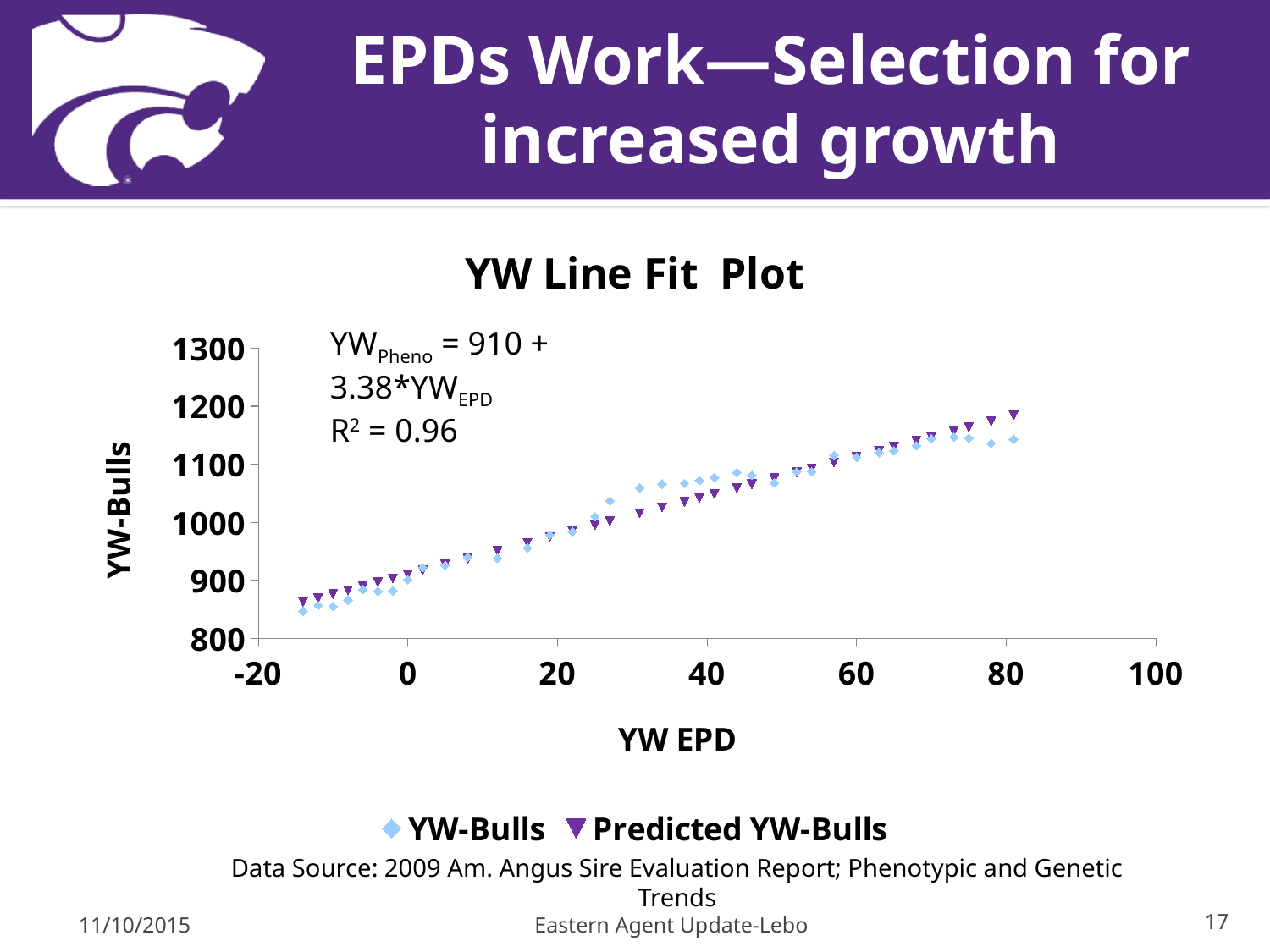
Is the Predicted YW-Bulls value at a YW EPD of about 0 greater or less than 1000? less What kind of chart is shown on the slide? Scatter chart Do the YW-Bulls values rise or fall as YW EPD increases along the x axis? Rise At a YW EPD of about 30, which series has the higher value, YW-Bulls or Predicted YW-Bulls? YW-Bulls What is the R² value shown on the chart? 0.96 Is the YW-Bulls value at a YW EPD of about 40 greater or less than 1000? greater What is the title of the chart? YW Line Fit Plot Is the YW-Bulls value at a YW EPD of about 80 greater or less than 1100? greater At a YW EPD of about 80, which series has the higher value, YW-Bulls or Predicted YW-Bulls? Predicted YW-Bulls How many series does the legend list? 2